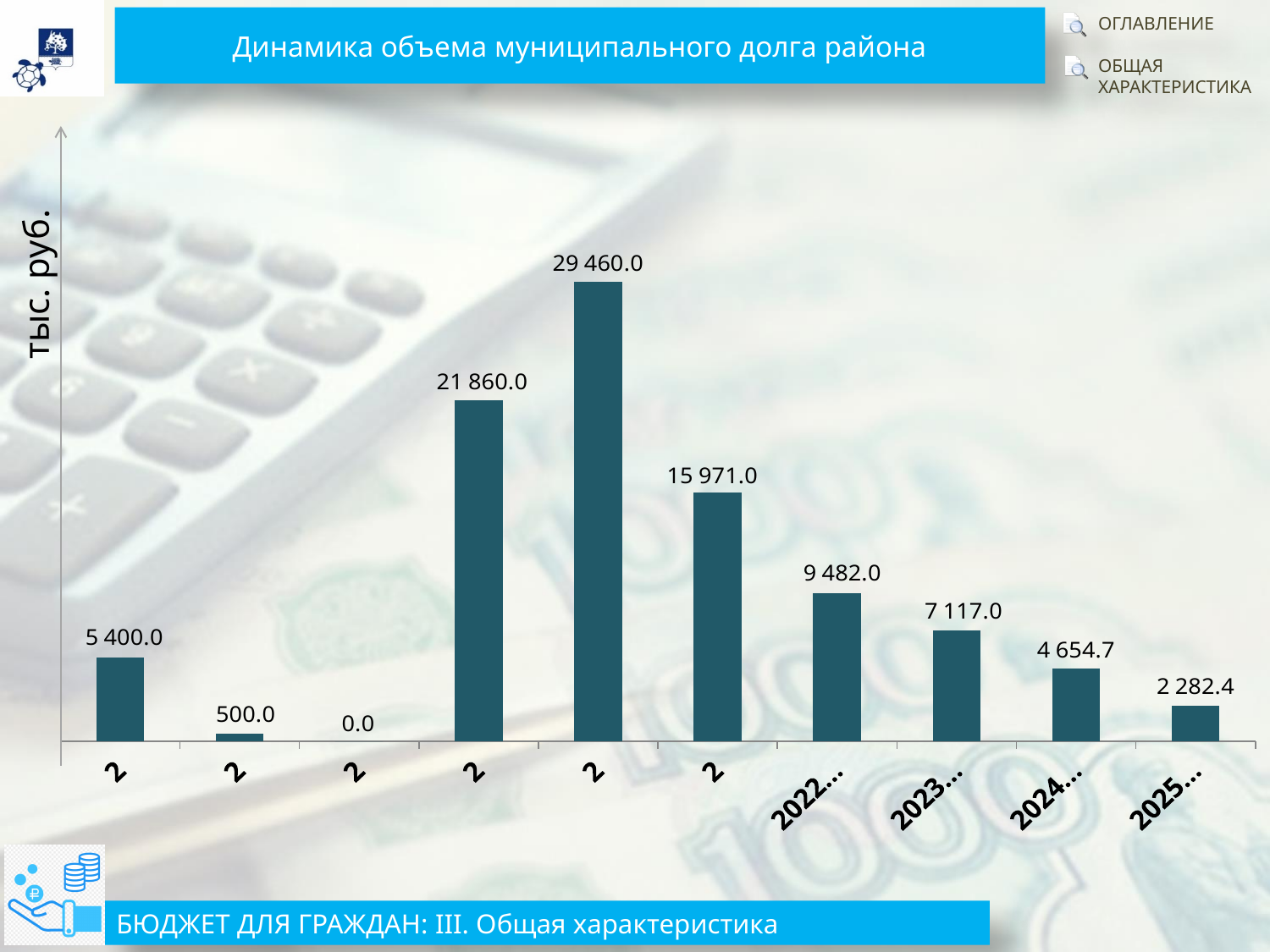
What is the value for the category labelled 2023...? 7 117.0 How many bars are plotted in the chart? 10 What is the lowest value shown in the chart? 0.0 What is the difference between the values for 2022... and 2023...? 2 365.0 Which is larger, the value for 2024... or the value for 2025...? 2024... Do the values rise or fall from the category 2022... to the category 2025...? fall What is the value for the category labelled 2022...? 9 482.0 What unit is shown on the vertical axis label of the chart? тыс. руб. What is the title of the chart? Динамика объема муниципального долга района What is the highest value shown in the chart? 29 460.0 What is the value for the category labelled 2025...? 2 282.4 What kind of chart is shown on the slide? bar chart